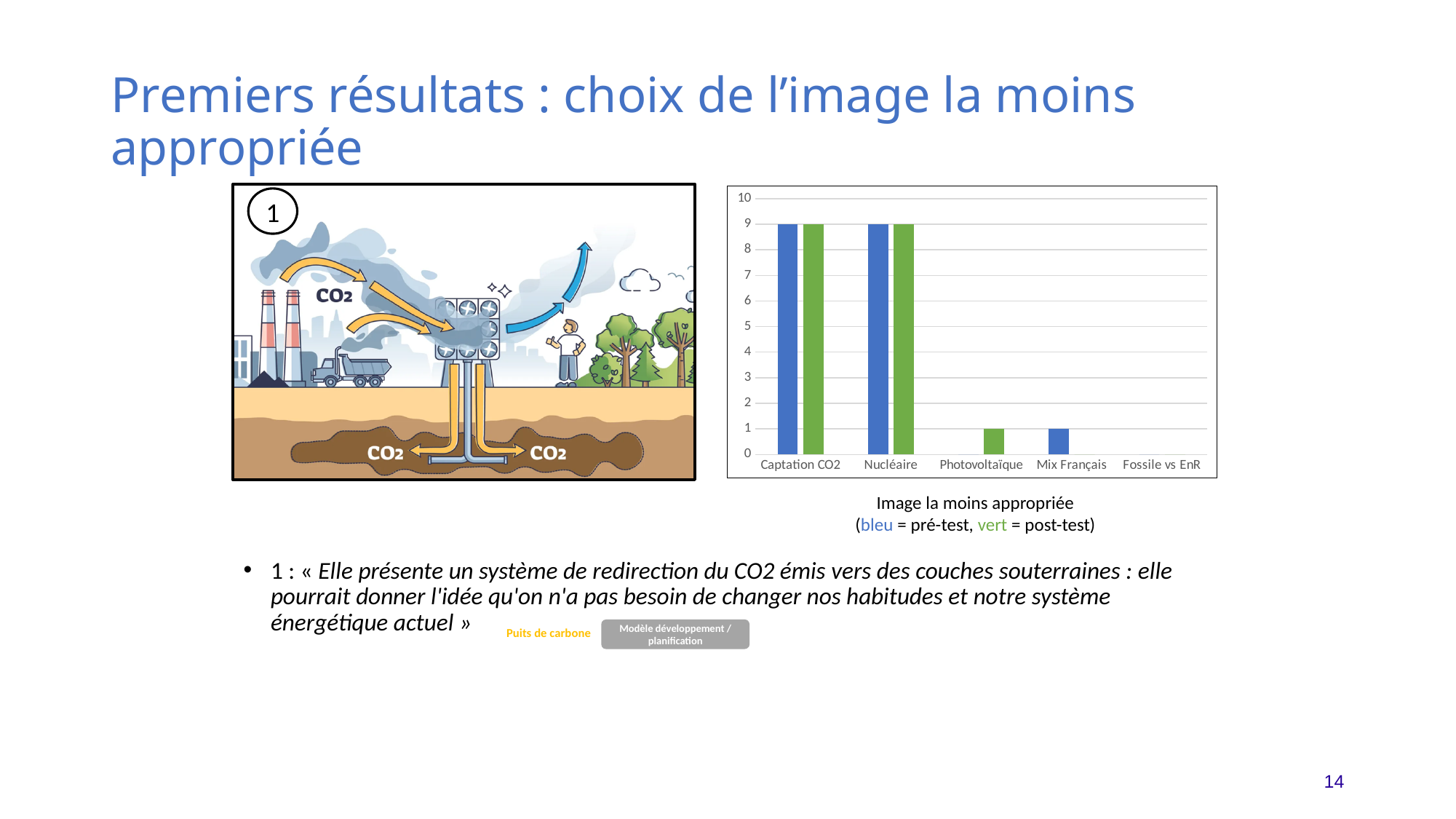
Is the pré-test value for Nucléaire greater or less than 5? greater What is the pré-test (blue) value for Captation CO2? 9 What kind of chart is shown on the slide? bar chart According to the caption, what does the blue colour represent in the chart? pré-test What is the difference between the pré-test value for Nucléaire and the post-test value for Photovoltaïque? 8 What is the post-test (green) value for Nucléaire? 9 Which is larger: the pré-test value for Captation CO2 or the pré-test value for Mix Français? Captation CO2 What is the post-test (green) value for Photovoltaïque? 1 What is the highest value shown on the y axis of the chart? 10 How many categories are shown on the x axis of the chart? 5 Which categories have the highest pré-test (blue) value? Captation CO2 and Nucléaire What is the pré-test (blue) value for Mix Français? 1